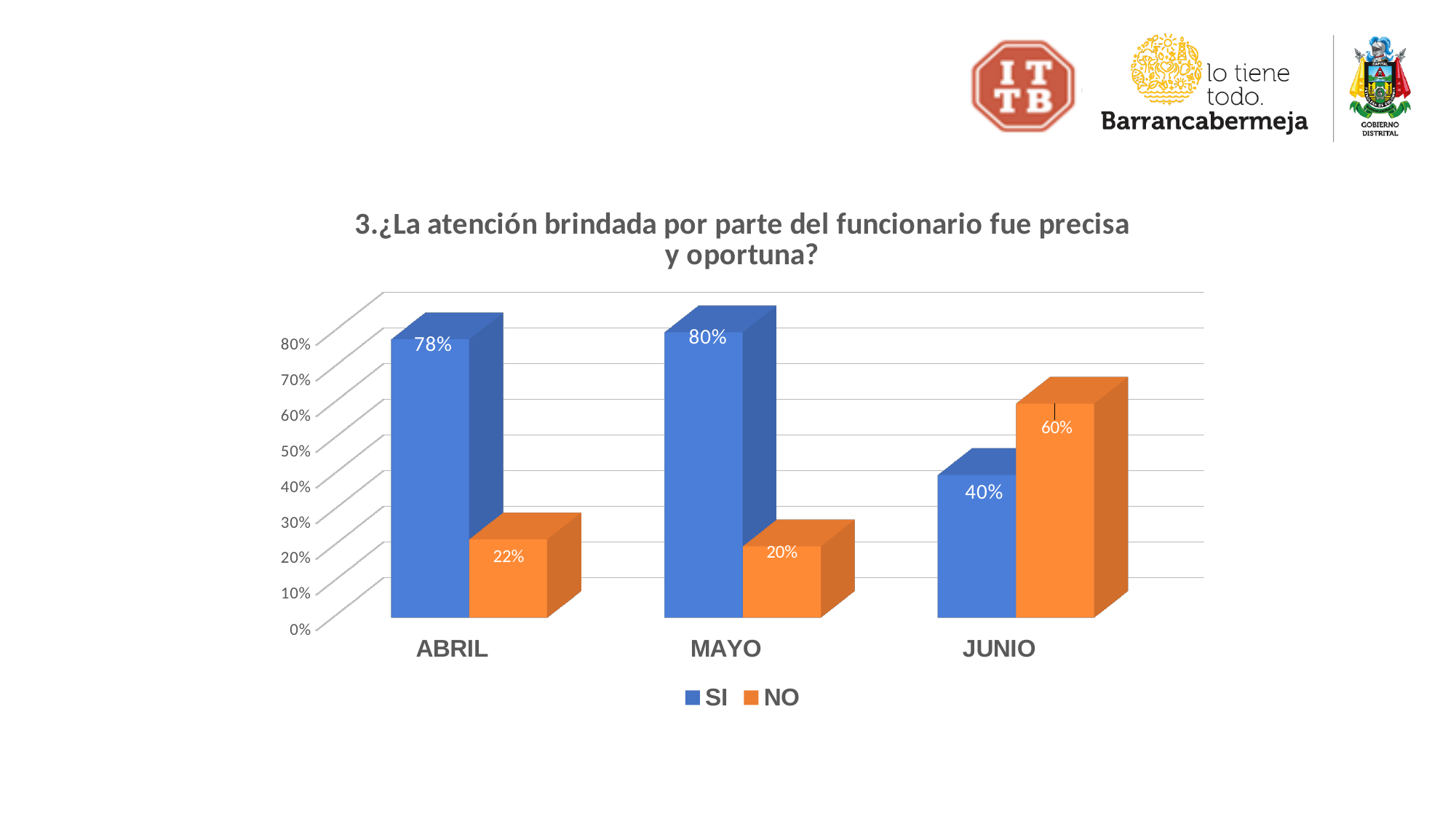
Which month has the lowest NO value? MAYO What is the NO value for JUNIO? 60% How many months are shown on the x axis? 3 What is the SI value for ABRIL? 78% What kind of chart is shown on the slide? Bar chart Which month has the highest SI value? MAYO Which is larger in JUNIO, the SI value or the NO value? NO How many series does the legend list? 2 What is the SI value for JUNIO? 40% Which colour represents the NO series? Orange What is the difference between the SI and NO values for ABRIL? 56% What is the NO value for MAYO? 20%